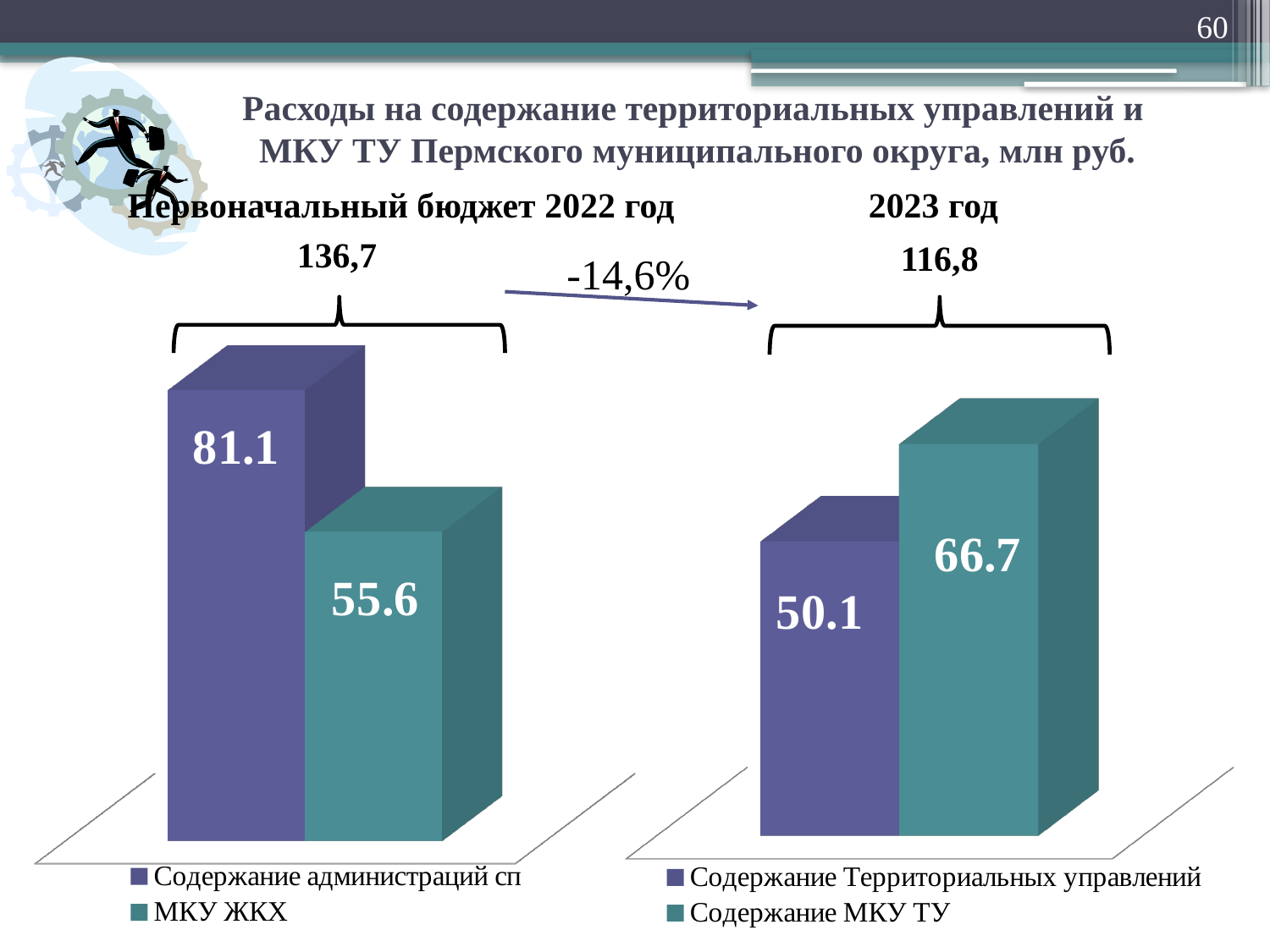
In the left chart (Первоначальный бюджет 2022 год), what is the value for Содержание администраций сп? 81.1 Is the value for Содержание МКУ ТУ in the right chart (2023 год) larger or smaller than the value for МКУ ЖКХ in the left chart (2022 год)? larger What total is printed above the left chart (Первоначальный бюджет 2022 год)? 136,7 In the left chart (Первоначальный бюджет 2022 год), what is the value for МКУ ЖКХ? 55.6 In the left chart (Первоначальный бюджет 2022 год), what is the difference between Содержание администраций сп and МКУ ЖКХ? 25.5 In the right chart (2023 год), what is the value for Содержание МКУ ТУ? 66.7 In the right chart (2023 год), what is the value for Содержание Территориальных управлений? 50.1 In the right chart (2023 год), which series has the lower value? Содержание Территориальных управлений What kind of chart is the left chart (Первоначальный бюджет 2022 год)? bar chart In the left chart (Первоначальный бюджет 2022 год), which series has the higher value? Содержание администраций сп In the right chart (2023 год), what is the difference between Содержание МКУ ТУ and Содержание Территориальных управлений? 16.6 How many series does the legend of the right chart (2023 год) list? 2